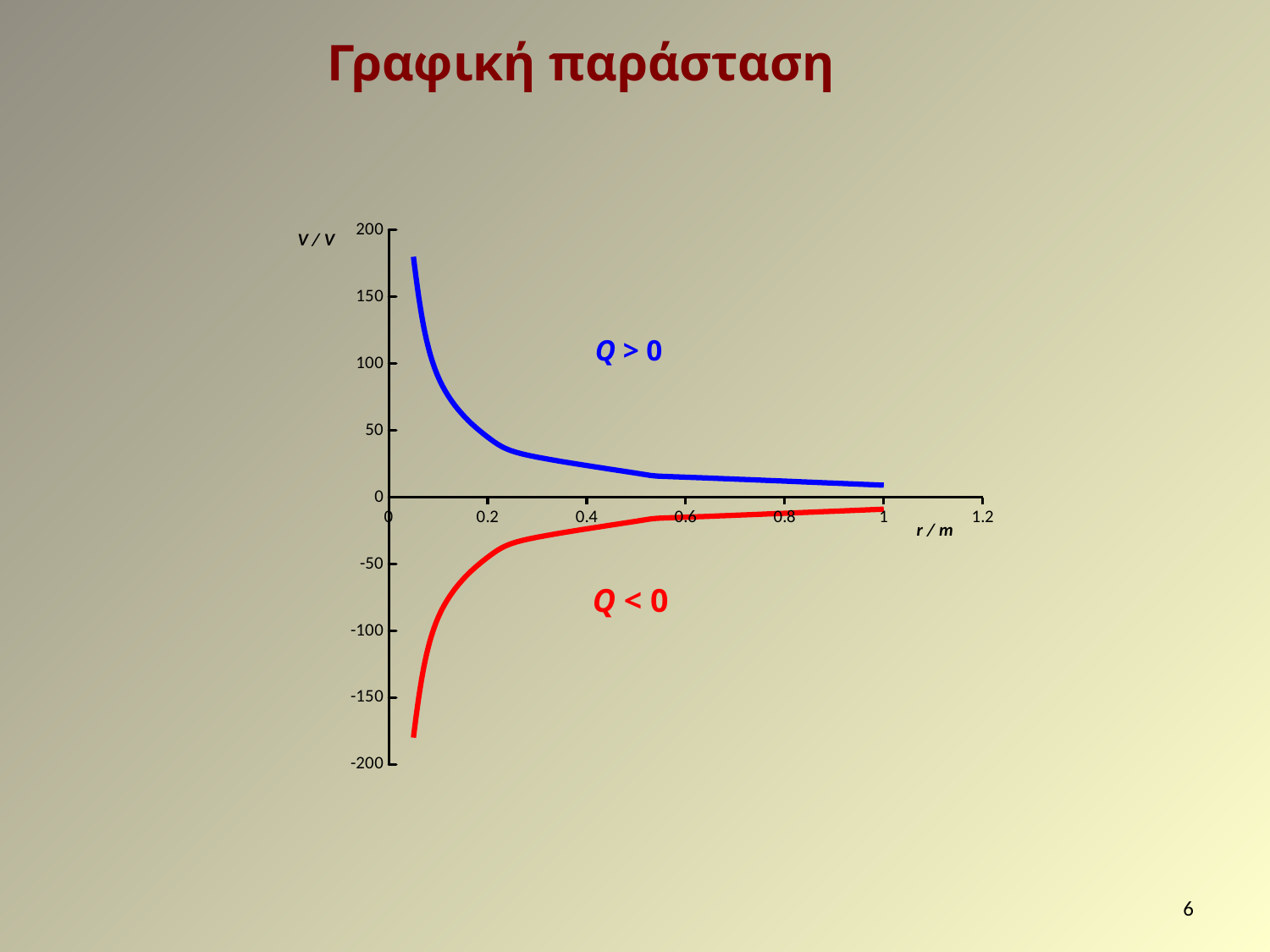
Does the Q > 0 curve rise or fall as r / m increases? fall Is the value of the Q < 0 curve at its leftmost point greater or less than -150? less At r / m = 0.2, which curve has the larger value, Q > 0 or Q < 0? Q > 0 What kind of chart is shown on the slide? line chart Does the Q < 0 curve rise or fall as r / m increases? rise What is the label on the vertical axis of the chart? V / V What is the largest tick value shown on the horizontal axis? 1.2 Is the value of the Q < 0 curve at r / m = 0.4 greater or less than -50? greater Is the value of the Q > 0 curve at its leftmost point greater or less than 150? greater What is the label on the horizontal axis of the chart? r / m How many curves are plotted on the chart? 2